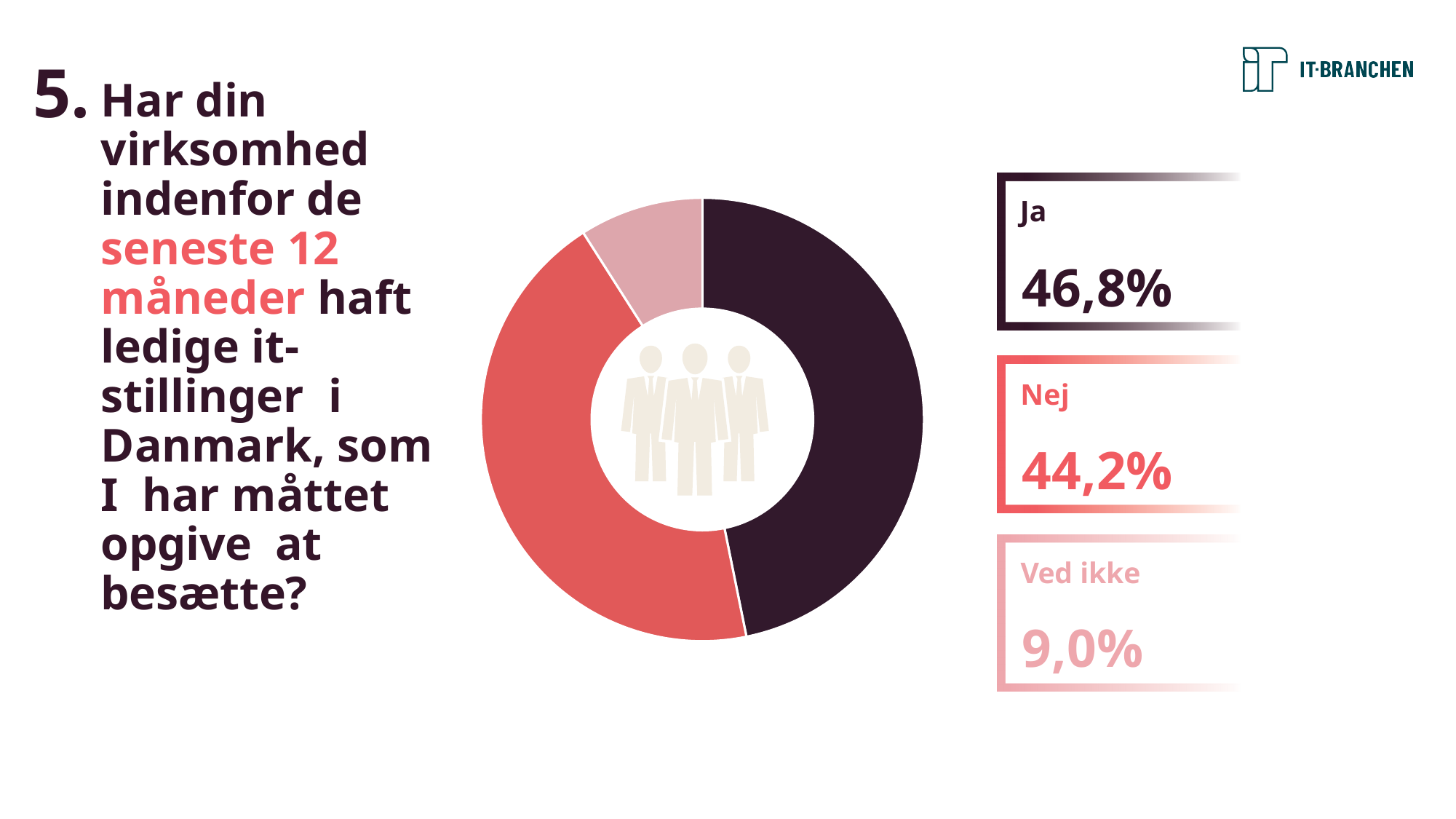
Which answer category has the smallest share in the chart? Ved ikke Which is larger, the share for "Ja" or the share for "Nej"? Ja What is the difference in percentage points between "Ja" and "Nej"? 2,6 percentage points Which answer category has the largest share in the chart? Ja What is the difference in percentage points between "Nej" and "Ved ikke"? 35,2 percentage points What kind of chart is shown on the slide? Pie chart (donut) What colour is the "Nej" slice of the chart? Red What percentage of respondents answered "Nej"? 44,2% What percentage of respondents answered "Ja"? 46,8% What percentage of respondents answered "Ved ikke"? 9,0% How many answer categories are shown in the chart? 3 What colour is the "Ja" slice of the chart? Dark purple